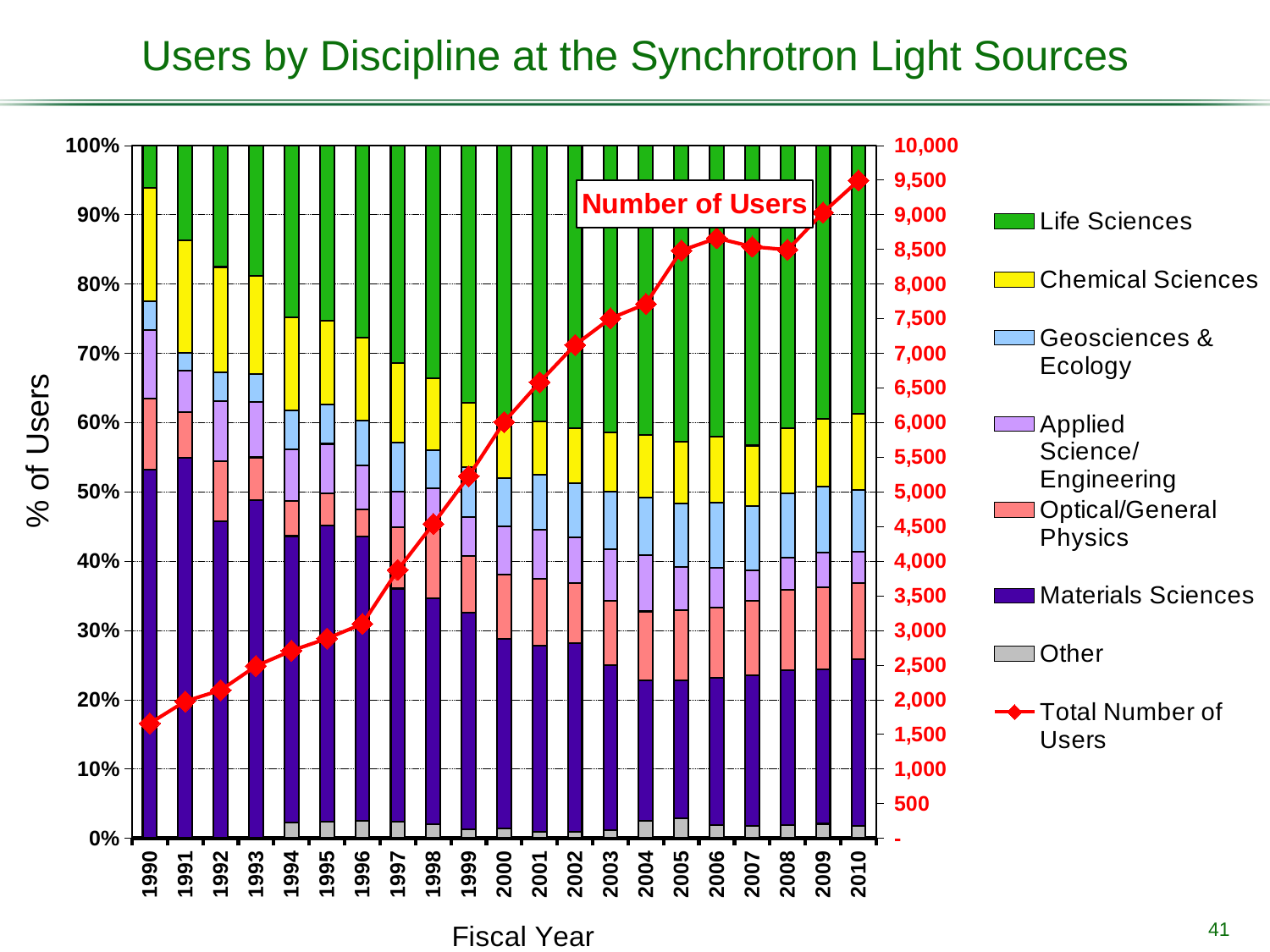
What is the title of the chart? Users by Discipline at the Synchrotron Light Sources Is the Total Number of Users in 1994 greater or less than 2,500? greater Does the Total Number of Users generally rise or fall from 1990 to 2010? rise What is the label of the x axis? Fiscal Year How many entries does the legend list? 8 Is the Total Number of Users in 1990 greater or less than 2,000? less Is the Total Number of Users in 2010 greater or less than 9,000? greater Which fiscal year has the highest Total Number of Users? 2010 Which fiscal year has the lowest Total Number of Users? 1990 Is the Materials Sciences share of users larger in 1990 or in 2010? 1990 What kind of chart is shown on the slide? Stacked bar chart with a line overlay How many fiscal years are shown on the x axis? 21